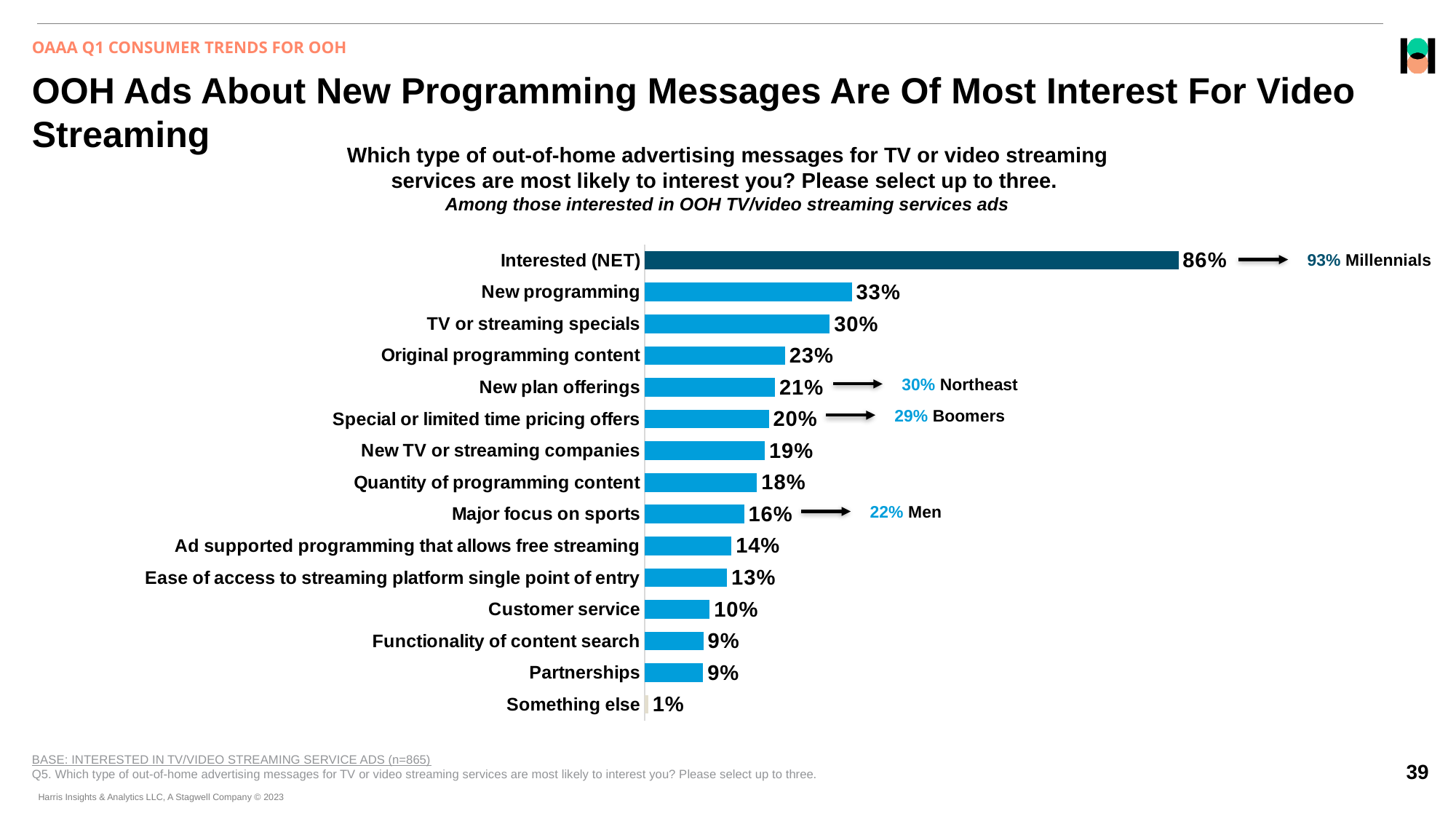
Which category has the lowest value? Something else How many categories are shown in the chart, including Interested (NET)? 15 What percentage of Millennials is shown in the callout next to the Interested (NET) bar? 93% What is the value for Special or limited time pricing offers? 20% What kind of chart is shown on the slide? Bar chart What percentage is shown for Customer service? 10% What is the difference between Original programming content and Major focus on sports? 7% What is the value for Interested (NET)? 86% What percentage is shown for New programming? 33% What is the difference between New programming and TV or streaming specials? 3% Which is larger, New plan offerings or Quantity of programming content? New plan offerings Excluding the Interested (NET) bar, which category has the highest value? New programming